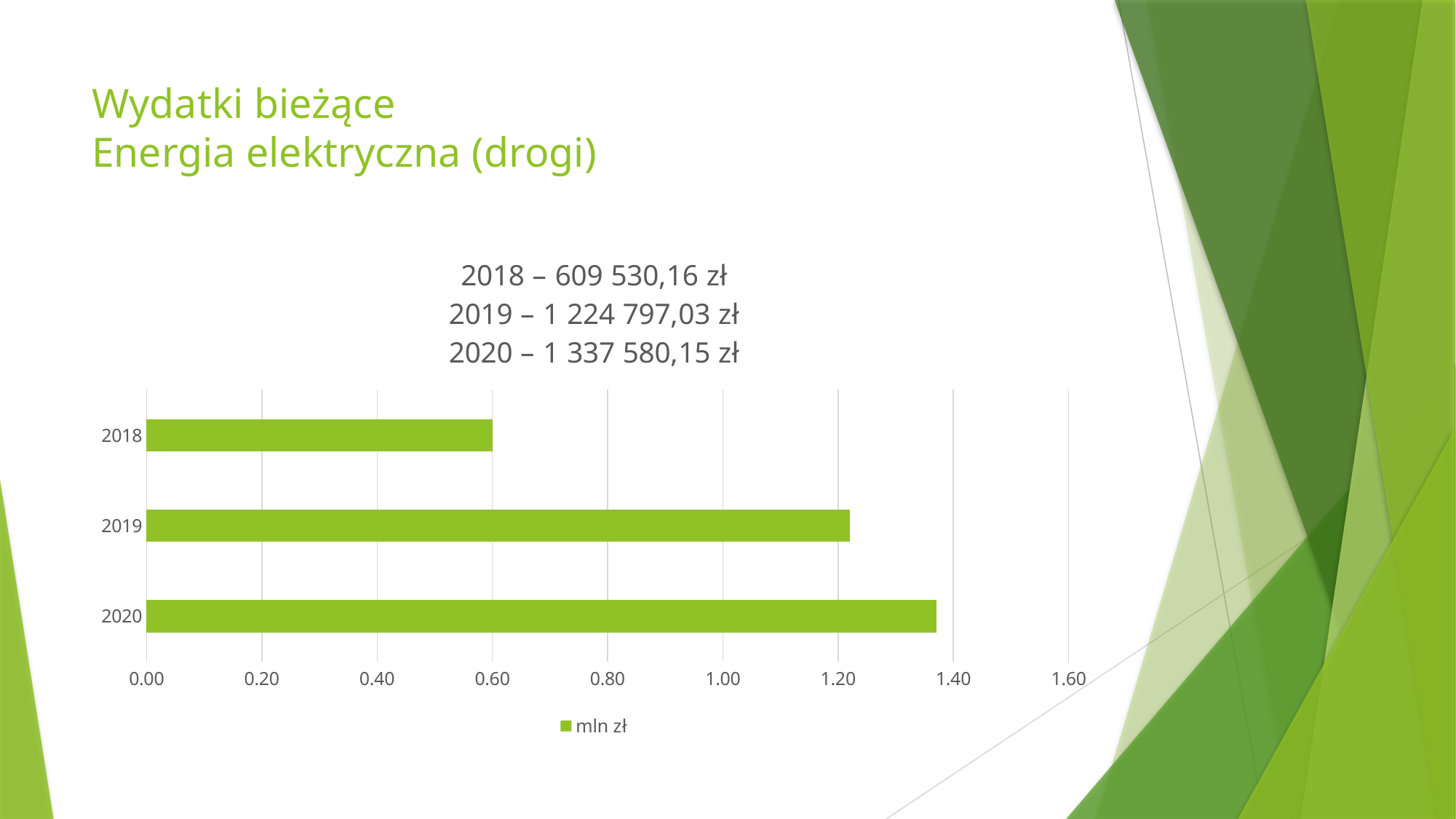
How many series does the chart legend list? 1 What is the legend entry of the chart? mln zł Which year has the longest bar in the chart? 2020 What kind of chart is shown on the slide? bar chart According to the slide, what was the electricity expenditure for roads in 2019? 1 224 797,03 zł Which year has the shortest bar in the chart? 2018 Do the values rise or fall from 2018 to 2020? rise Is the value for 2019 greater or less than 1.00? greater How many years (categories) are plotted in the chart? 3 Is the value for 2018 greater or less than 0.80? less Is the value for 2020 greater or less than 1.20? greater Which year has the larger value, 2018 or 2019? 2019